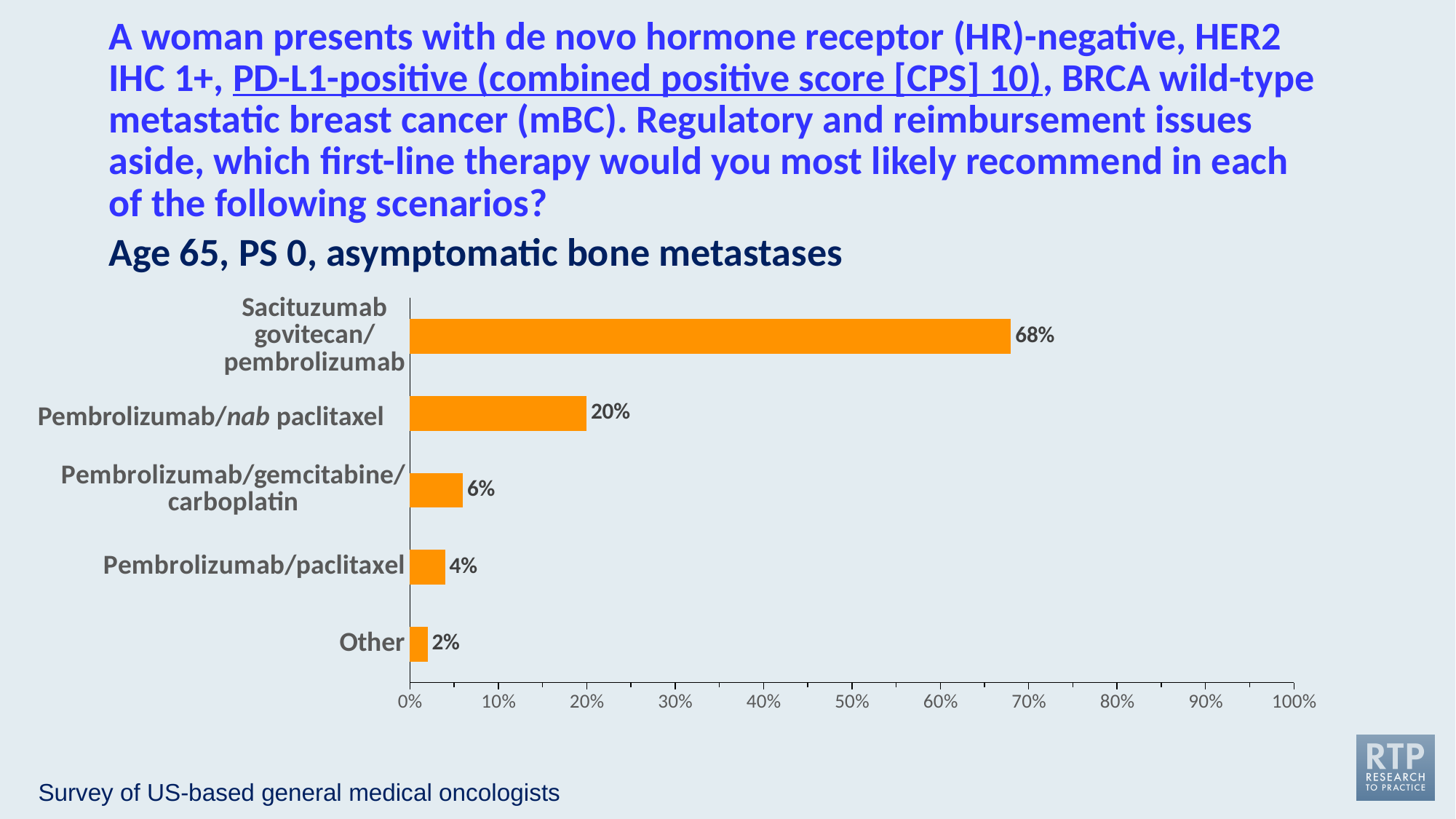
How many therapy options are shown in the chart? 5 What type of chart is shown on the slide? Bar chart Which received a larger share of responses: pembrolizumab/gemcitabine/carboplatin or pembrolizumab/paclitaxel? Pembrolizumab/gemcitabine/carboplatin What percentage of respondents chose Other? 2% What percentage of respondents chose pembrolizumab/paclitaxel? 4% Which therapy option received the lowest percentage of responses? Other What percentage of respondents chose pembrolizumab/nab paclitaxel? 20% Which therapy option received the highest percentage of responses? Sacituzumab govitecan/pembrolizumab What is the difference in percentage points between sacituzumab govitecan/pembrolizumab and pembrolizumab/nab paclitaxel? 48 percentage points What percentage of respondents chose sacituzumab govitecan/pembrolizumab? 68% What percentage of respondents chose pembrolizumab/gemcitabine/carboplatin? 6% What is the maximum value shown on the x axis of the chart? 100%